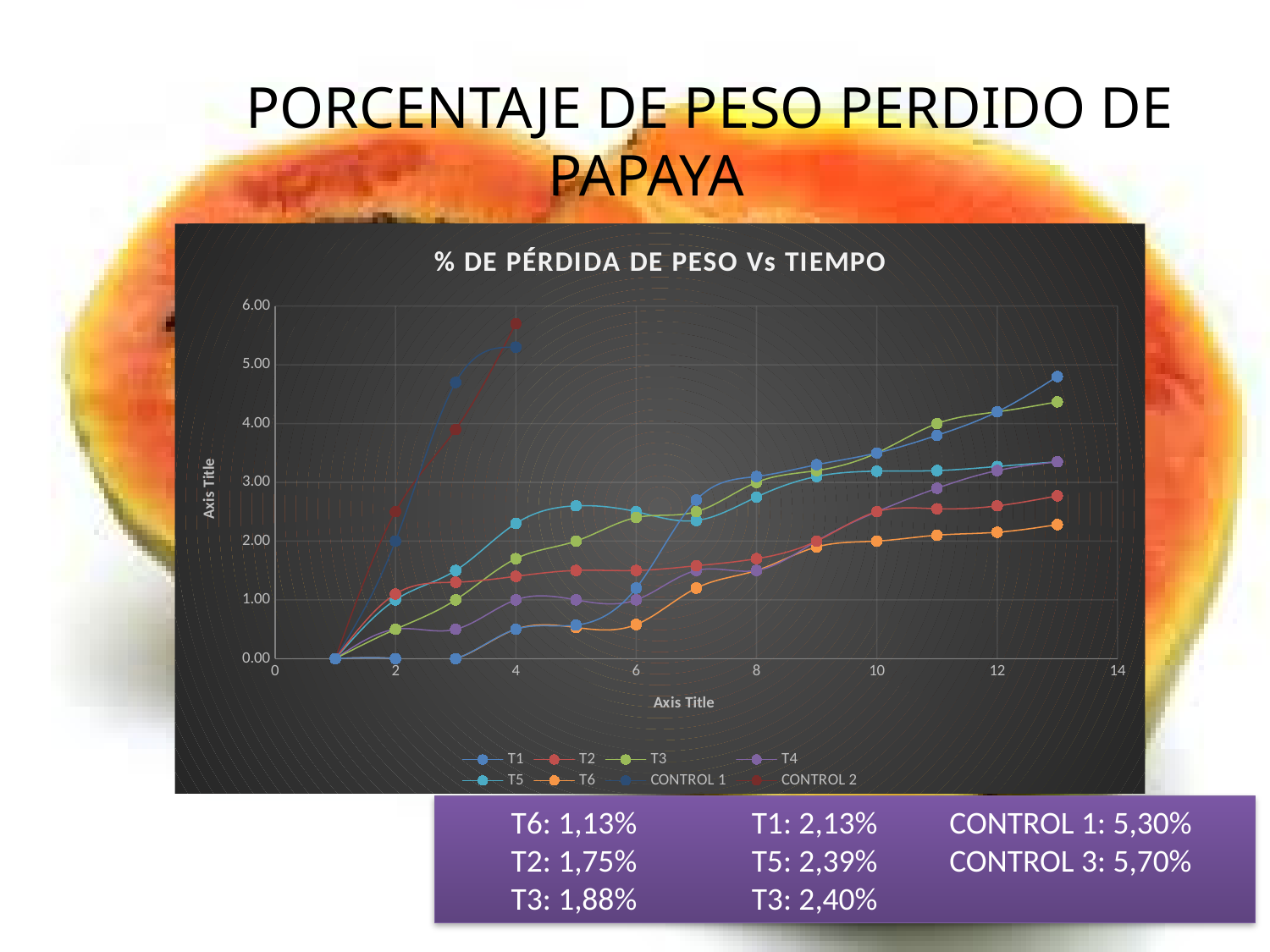
Is the value for T1 at x = 3 greater or less than 1.00? less Which series reaches the highest value on the chart? CONTROL 2 Is the value for T6 at x = 13 greater or less than 3.00? less Which series are listed in the chart legend? T1, T2, T3, T4, T5, T6, CONTROL 1, CONTROL 2 Is the value for T1 at x = 13 greater or less than 4.00? greater Does the T1 series generally rise or fall as x increases from 3 to 13? rise What is the title of the chart? % DE PÉRDIDA DE PESO Vs TIEMPO What kind of chart is shown on the slide? line chart How many series does the chart legend list? 8 Which series has the lowest value at x = 13? T6